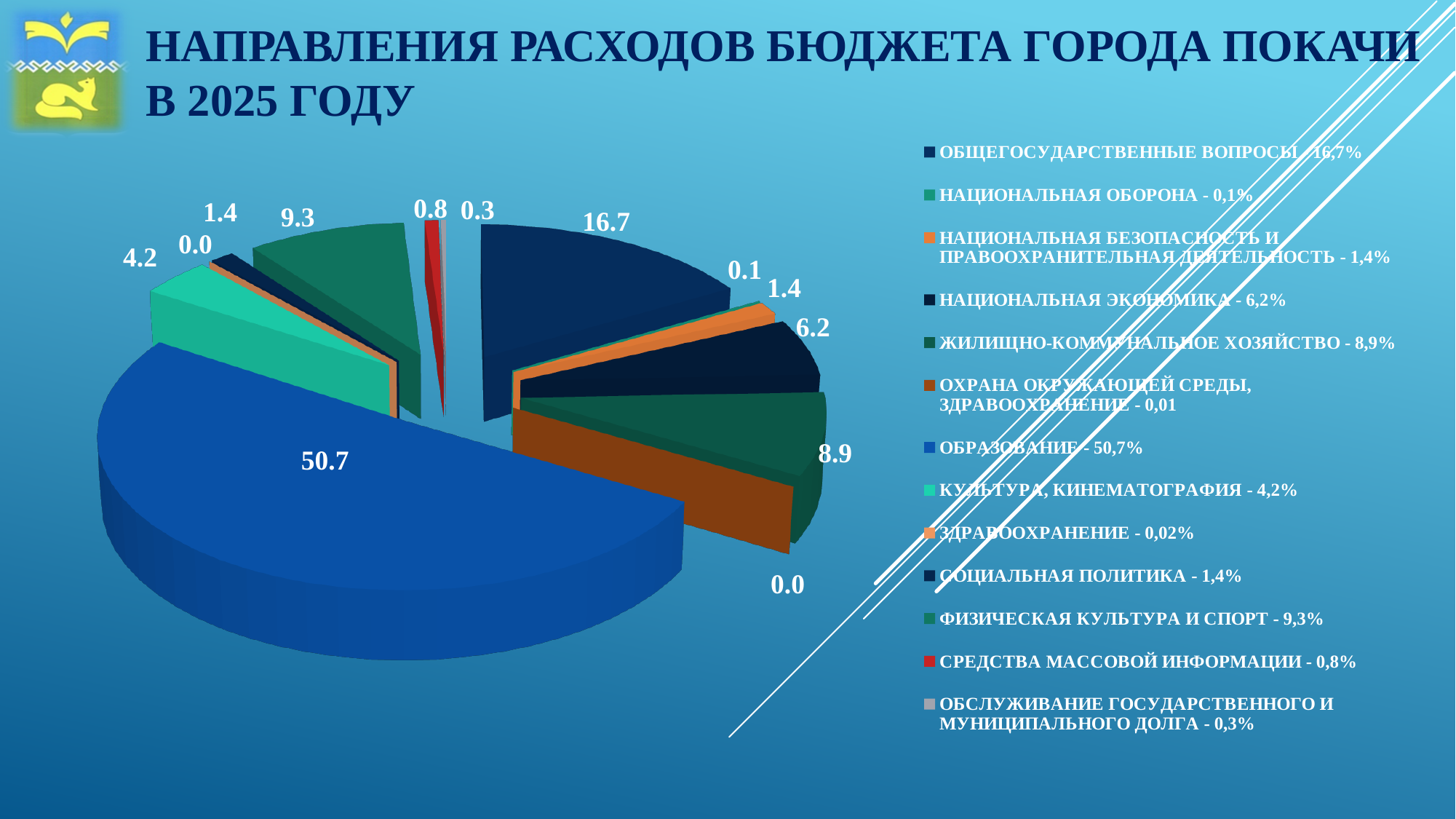
What percentage does the legend give for НАЦИОНАЛЬНАЯ ЭКОНОМИКА? 6,2% Which is larger, the value for ФИЗИЧЕСКАЯ КУЛЬТУРА И СПОРТ or the value for ЖИЛИЩНО-КОММУНАЛЬНОЕ ХОЗЯЙСТВО? ФИЗИЧЕСКАЯ КУЛЬТУРА И СПОРТ Is the value for ОБРАЗОВАНИЕ greater or less than 50? greater What is the value shown for ФИЗИЧЕСКАЯ КУЛЬТУРА И СПОРТ on the pie chart? 9.3 What is the value shown for ОБЩЕГОСУДАРСТВЕННЫЕ ВОПРОСЫ on the pie chart? 16.7 What is the difference between the values for ОБЩЕГОСУДАРСТВЕННЫЕ ВОПРОСЫ and НАЦИОНАЛЬНАЯ ЭКОНОМИКА? 10.5 What is the value shown for ОБРАЗОВАНИЕ on the pie chart? 50.7 How many categories does the legend list? 13 What share of the pie does КУЛЬТУРА, КИНЕМАТОГРАФИЯ represent according to the legend? 4,2% What is the difference between the values for ОБРАЗОВАНИЕ and ОБЩЕГОСУДАРСТВЕННЫЕ ВОПРОСЫ? 34.0 Which category has the largest slice of the pie? ОБРАЗОВАНИЕ What kind of chart is shown on the slide? pie chart